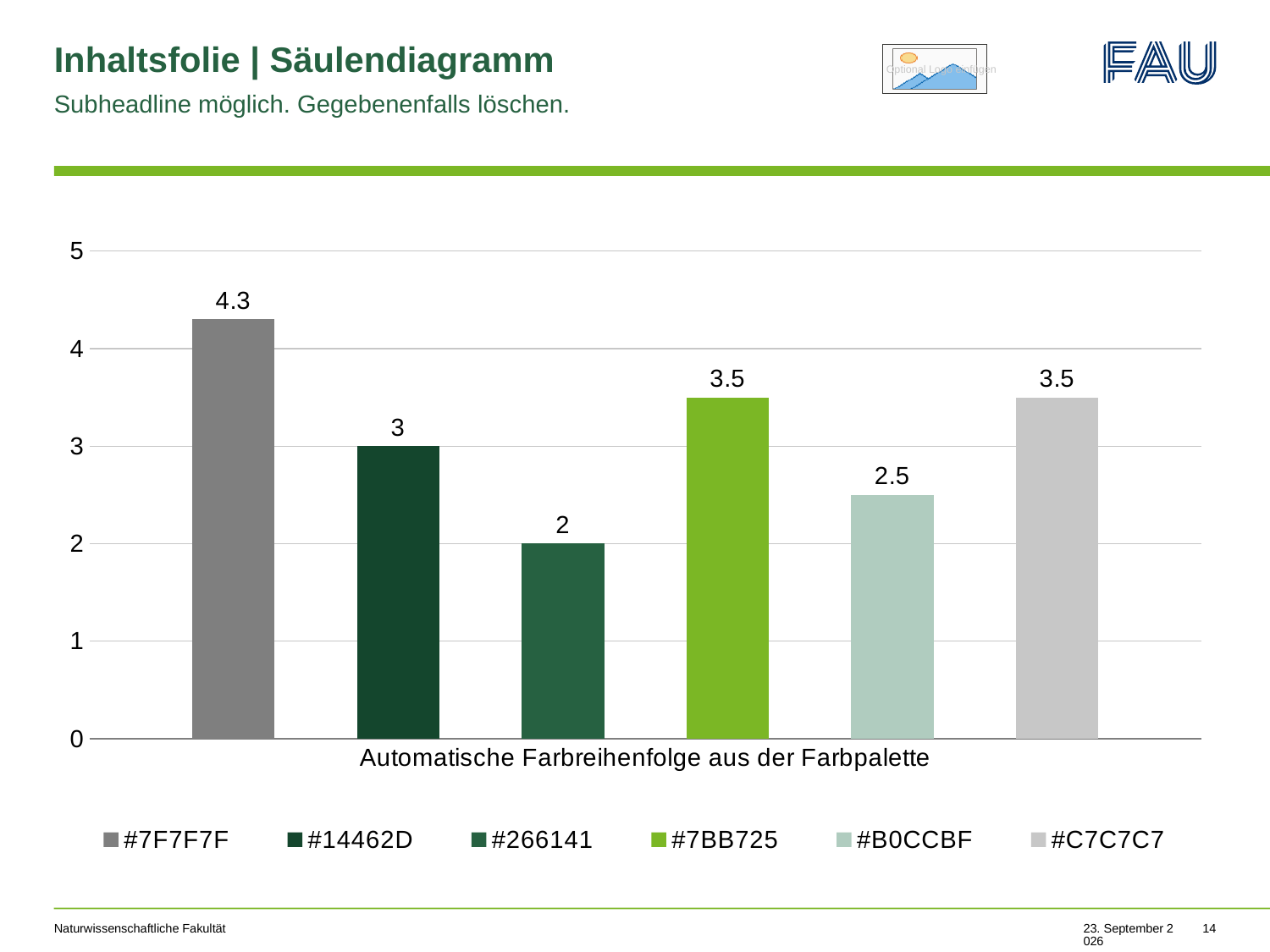
How many series does the legend list? 6 What is the category label shown on the x axis? Automatische Farbreihenfolge aus der Farbpalette Which series has the highest value? #7F7F7F What is the difference between the values of #7F7F7F and #14462D? 1.3 What is the value of the #7F7F7F series? 4.3 Which is larger, the value of #7BB725 or the value of #B0CCBF? #7BB725 What kind of chart is shown on the slide? bar chart Which series has the lowest value? #266141 What is the value of the #B0CCBF series? 2.5 What is the value of the #266141 series? 2 Is the value for #C7C7C7 greater or less than 3? greater What is the value of the #14462D series? 3